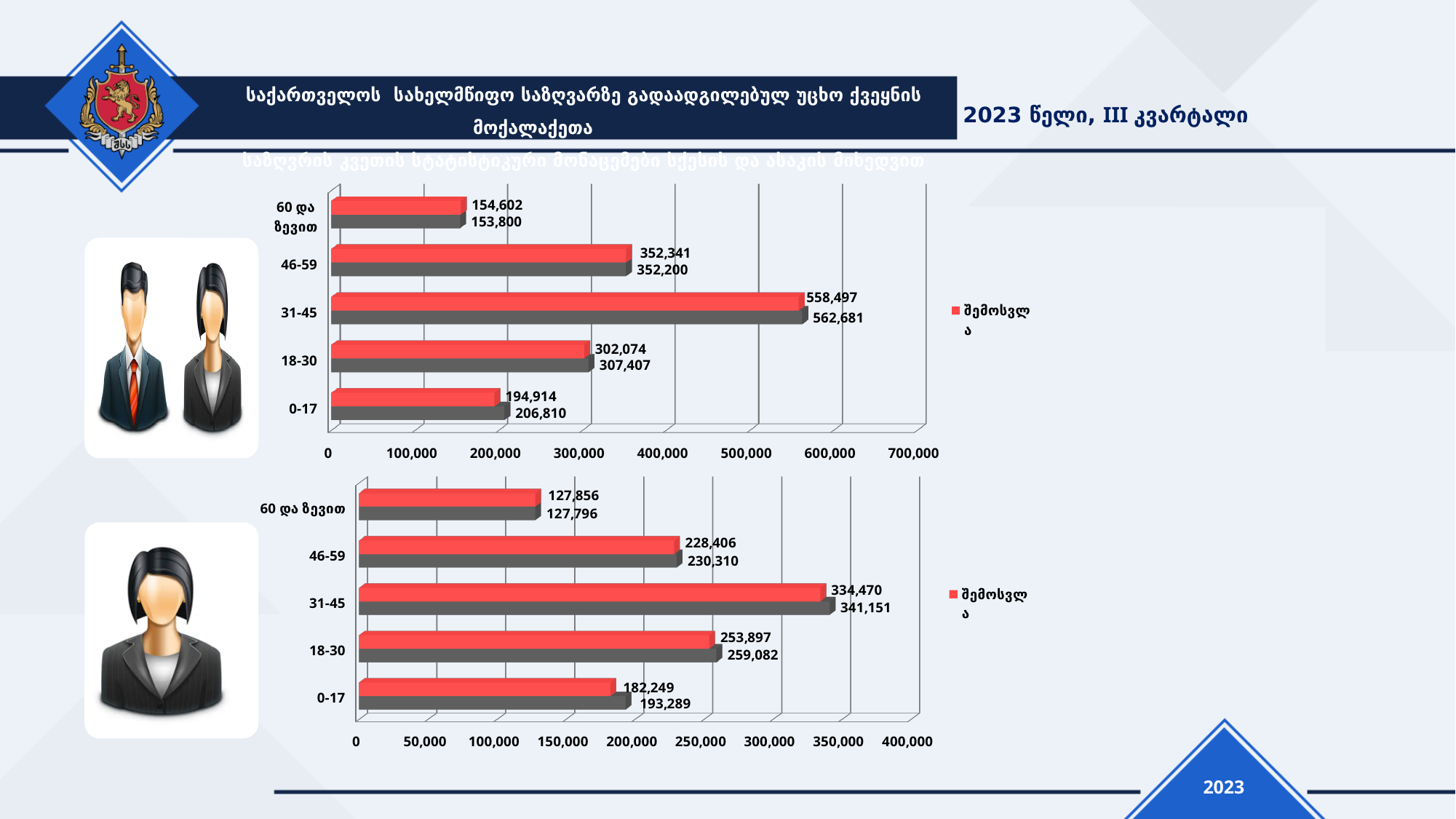
How many age groups are shown in the top chart? 5 In the top chart, what is the difference between the grey bar and the red bar for the 0-17 age group? 11,896 In the bottom chart, which age group has the lowest grey bar value? 60 და ზევით In the bottom chart, what is the difference between the grey bar and the red bar for the 31-45 age group? 6,681 What type of chart is the bottom chart? Bar chart In the top chart, which age group has the highest red bar value? 31-45 In the bottom chart, what is the value of the red bar for the 46-59 age group? 228,406 In the top chart, what is the value of the red bar for the 31-45 age group? 558,497 In the top chart, which red bar is larger: 18-30 or 46-59? 46-59 In the bottom chart, is the red bar value for the 0-17 age group greater or less than 200,000? less In the top chart, what is the value of the grey bar for the 0-17 age group? 206,810 In the bottom chart, what is the value of the grey bar for the 18-30 age group? 259,082